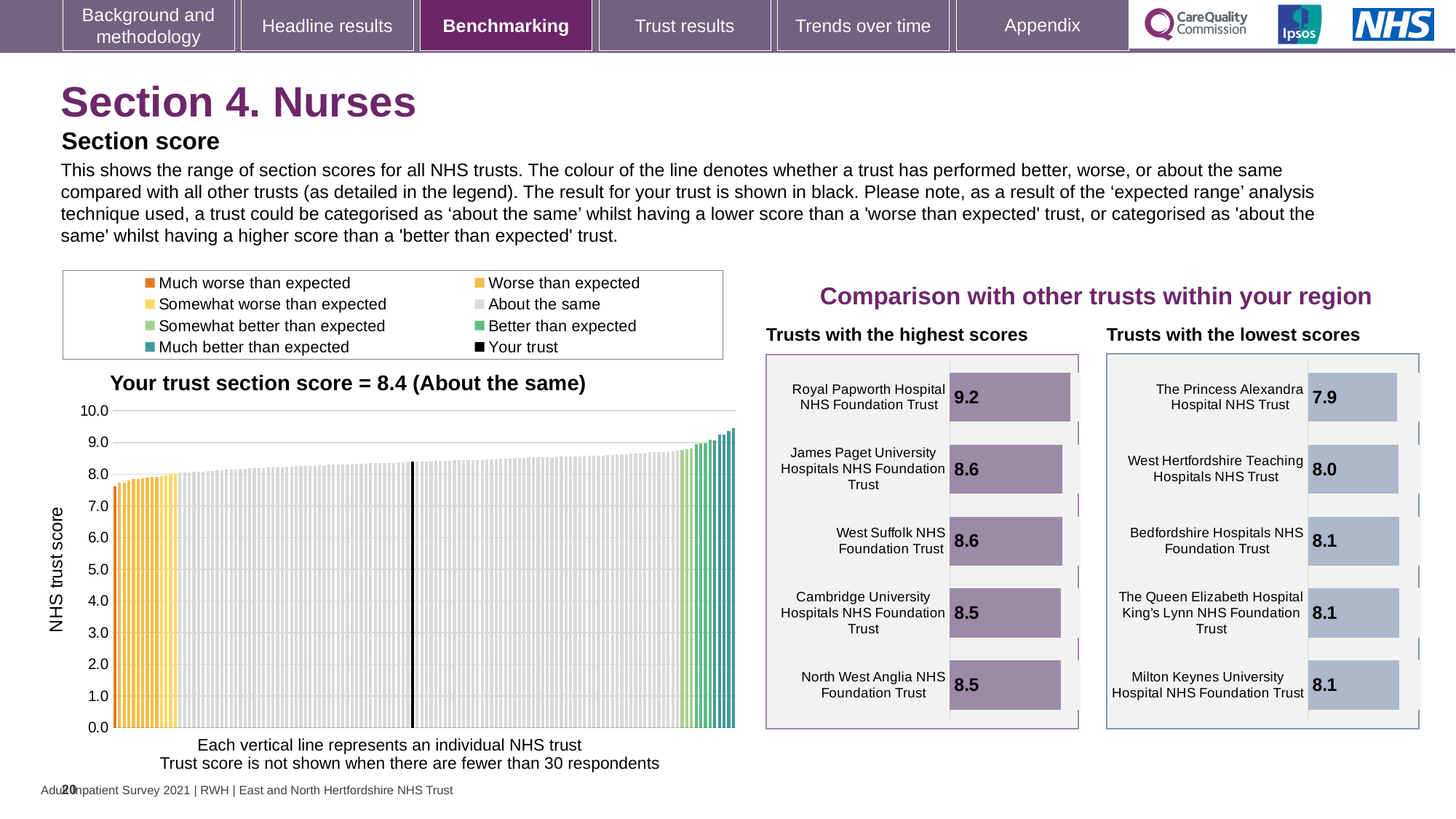
On the 'Trusts with the highest scores' chart, which trust has the highest score? Royal Papworth Hospital NHS Foundation Trust On the 'Your trust section score' chart, what is the label of the vertical axis? NHS trust score On the 'Your trust section score' chart, how many entries does the legend list? 8 On the 'Your trust section score' chart, what is the section score for your trust? 8.4 On the 'Trusts with the lowest scores' chart, what is the score for The Princess Alexandra Hospital NHS Trust? 7.9 On the 'Your trust section score' chart, is the value for your trust (the black line) greater or less than 8.0? greater On the 'Trusts with the lowest scores' chart, which is larger: the score for West Hertfordshire Teaching Hospitals NHS Trust or Bedfordshire Hospitals NHS Foundation Trust? Bedfordshire Hospitals NHS Foundation Trust On the 'Trusts with the highest scores' chart, what is the score for Royal Papworth Hospital NHS Foundation Trust? 9.2 On the 'Your trust section score' chart, what kind of chart is shown? bar chart On the 'Trusts with the highest scores' chart, how many trusts are shown? 5 On the 'Trusts with the lowest scores' chart, which trust has the lowest score? The Princess Alexandra Hospital NHS Trust On the 'Trusts with the highest scores' chart, what is the difference between the scores of Royal Papworth Hospital NHS Foundation Trust and North West Anglia NHS Foundation Trust? 0.7